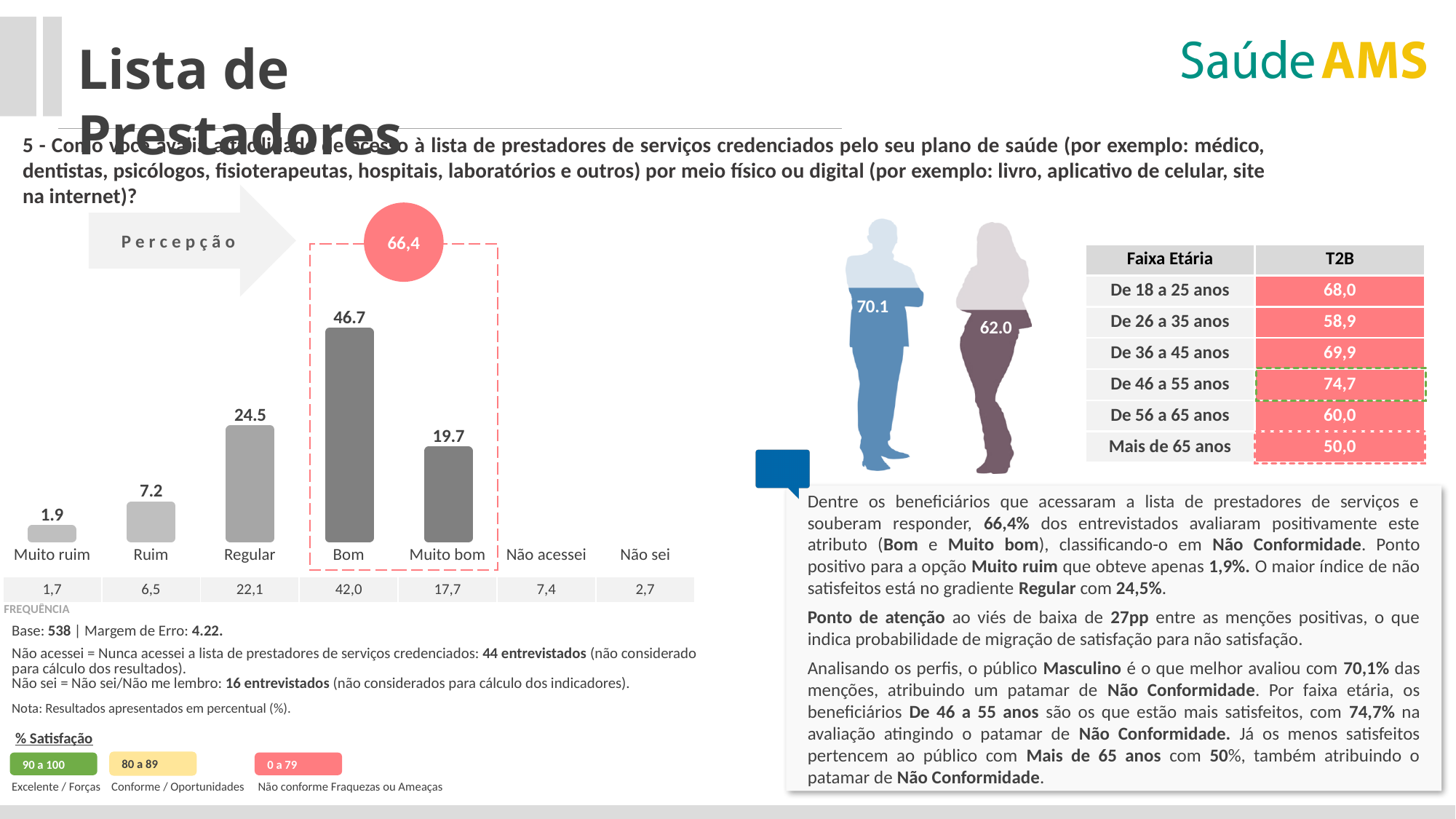
What is the difference between the Bom and Muito bom values? 27.0 What is the value shown for the Bom bar? 46.7 What kind of chart is shown on the slide? Bar chart What is the value shown for the Ruim bar? 7.2 Which is larger, the value for Regular or the value for Muito bom? Regular Which category has the highest bar in the chart? Bom How many bars are plotted in the chart? 5 What is the value shown for the Muito ruim bar? 1.9 What is the value shown for the Regular bar? 24.5 What value is shown in the red circle above the highlighted Bom and Muito bom bars? 66,4 Which category has the lowest bar in the chart? Muito ruim What is the difference between the Regular and Ruim values? 17.3